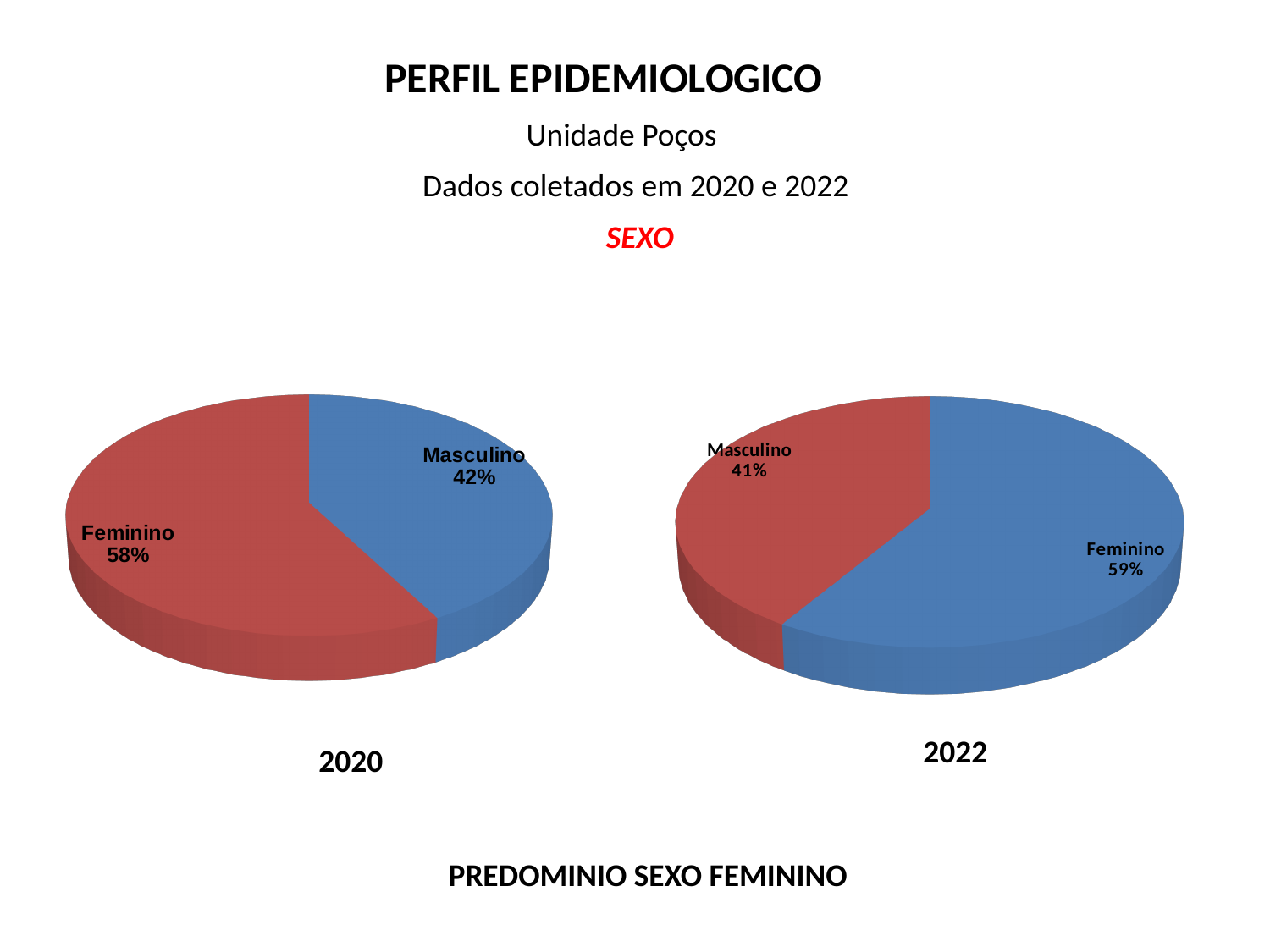
In the 2022 pie chart, what is the share for Feminino? 59% How many slices does the 2020 pie chart have? 2 In the 2020 pie chart, what is the difference in percentage points between Feminino and Masculino? 16 What colour is the Feminino slice in the 2022 pie chart? Blue In the 2022 pie chart, which category has the smallest slice? Masculino Which is larger: the Feminino share in 2020 or the Feminino share in 2022? 2022 In the 2020 pie chart, what is the share for Masculino? 42% In the 2022 pie chart, what is the share for Masculino? 41% In the 2020 pie chart, which category has the largest slice? Feminino In the 2020 pie chart, what is the share for Feminino? 58% In the 2022 pie chart, what is the difference in percentage points between Feminino and Masculino? 18 What type of chart is used on this slide? Pie chart